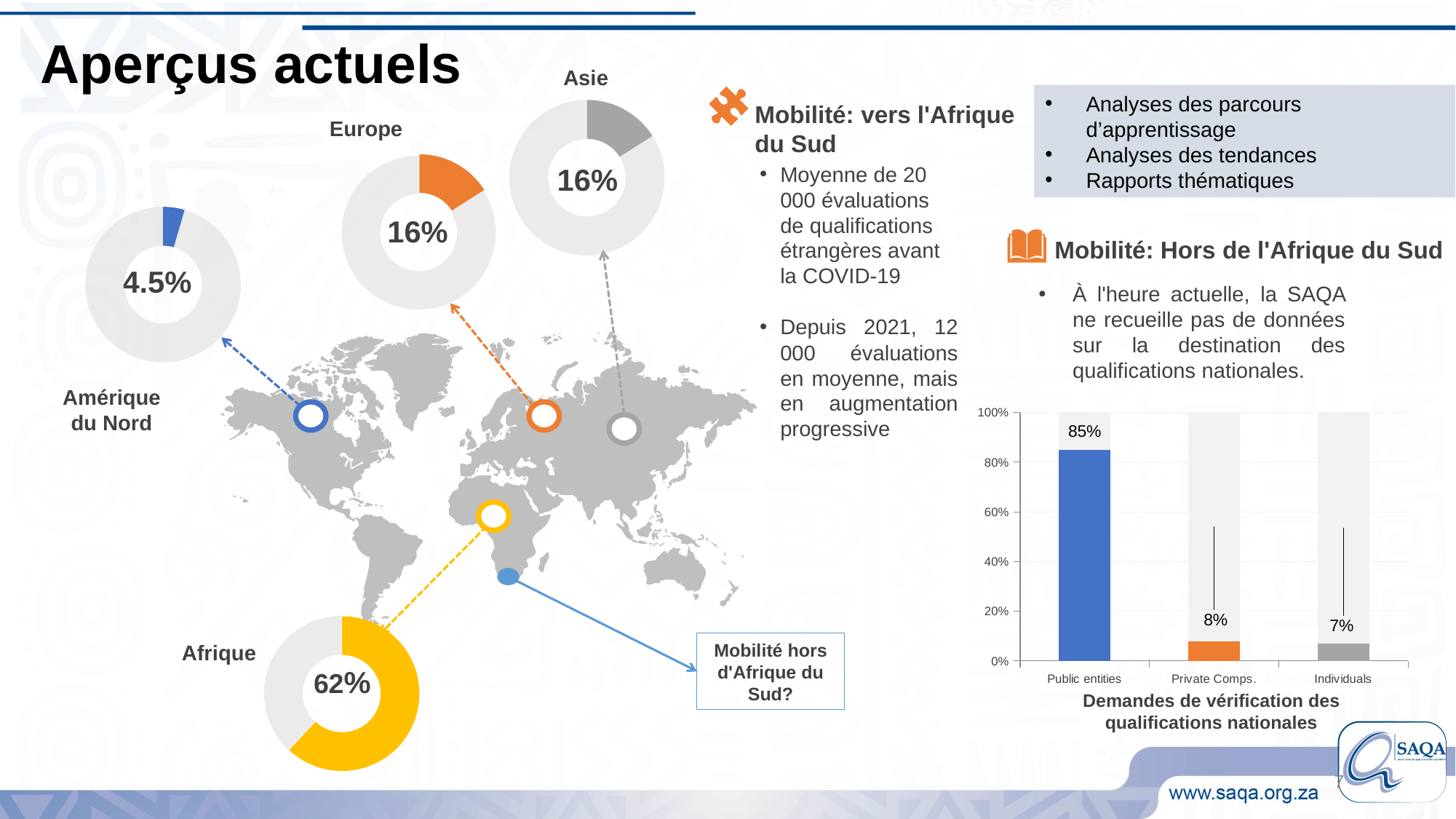
Which is larger: the percentage in the 'Europe' donut chart or the percentage in the 'Amérique du Nord' donut chart? Europe Among the donut charts labelled Amérique du Nord, Europe, Asie and Afrique, which region has the highest percentage? Afrique What kind of chart is 'Demandes de vérification des qualifications nationales'? Bar chart In the bar chart titled 'Demandes de vérification des qualifications nationales', what is the difference between Public entities and Private Comps.? 77% In the bar chart titled 'Demandes de vérification des qualifications nationales', is the value for Public entities greater or less than 80%? greater In the bar chart titled 'Demandes de vérification des qualifications nationales', what is the value for Individuals? 7% In the donut chart labelled 'Afrique' at the bottom left of the slide, what percentage is shown? 62% In the bar chart titled 'Demandes de vérification des qualifications nationales', which category has the highest value? Public entities In the bar chart titled 'Demandes de vérification des qualifications nationales', what is the value for Private Comps.? 8% In the bar chart titled 'Demandes de vérification des qualifications nationales', how many categories are shown on the x axis? 3 In the bar chart titled 'Demandes de vérification des qualifications nationales', what is the value for Public entities? 85% In the donut chart labelled 'Amérique du Nord', what percentage is shown? 4.5%